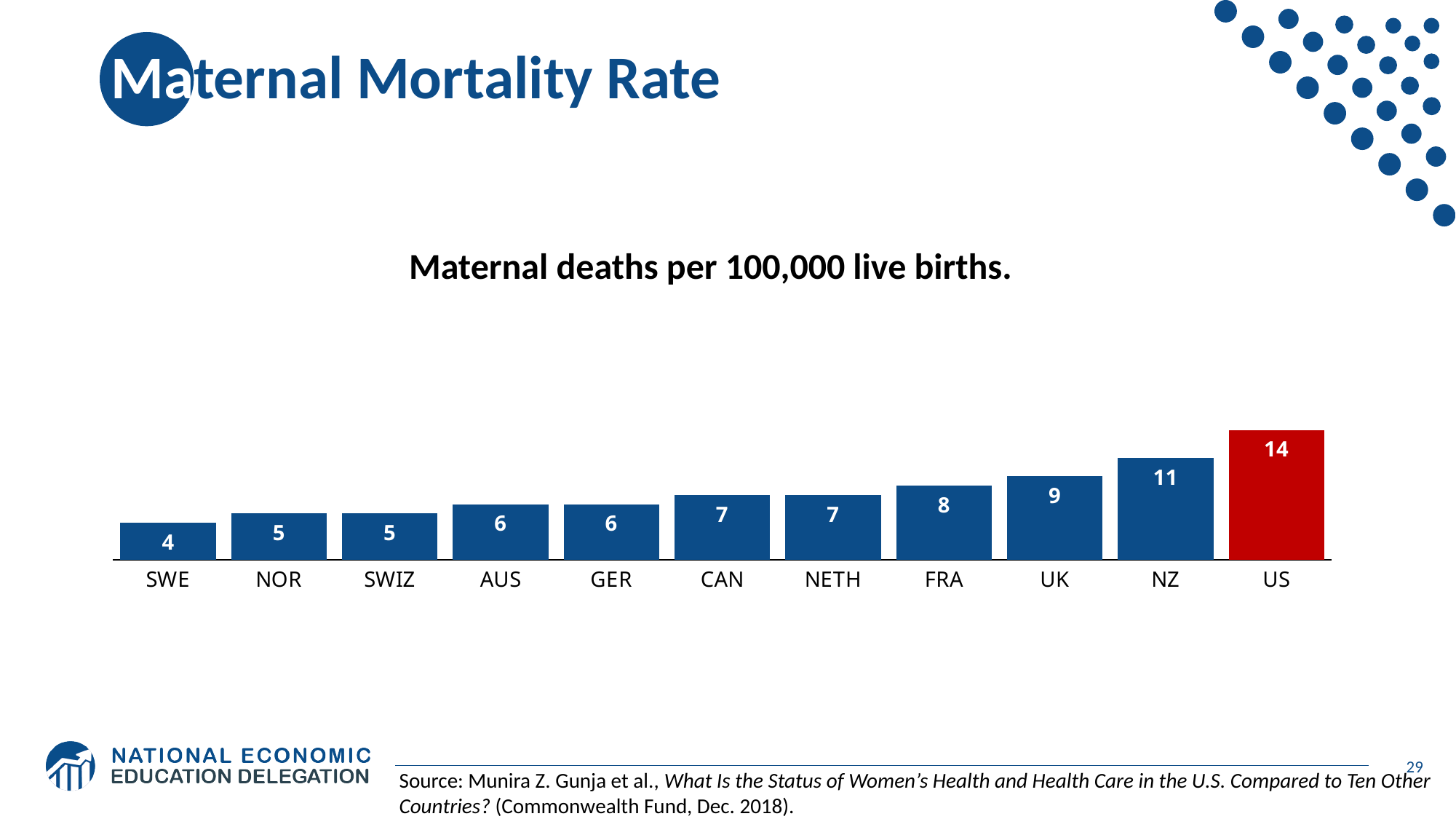
Which has a higher value, CAN or NOR? CAN What is the difference between the values for the US and the UK? 5 What type of chart is shown on the slide? Bar chart What is the difference between the values for NZ and SWE? 7 What value is shown for SWE? 4 What is the value for NZ? 11 Which country has the highest maternal mortality rate on the chart? US How many countries are shown on the chart? 11 What is the maternal mortality rate shown for the US? 14 Which country has the lowest maternal mortality rate on the chart? SWE Which bar is coloured red rather than blue? US What value is shown for FRA? 8